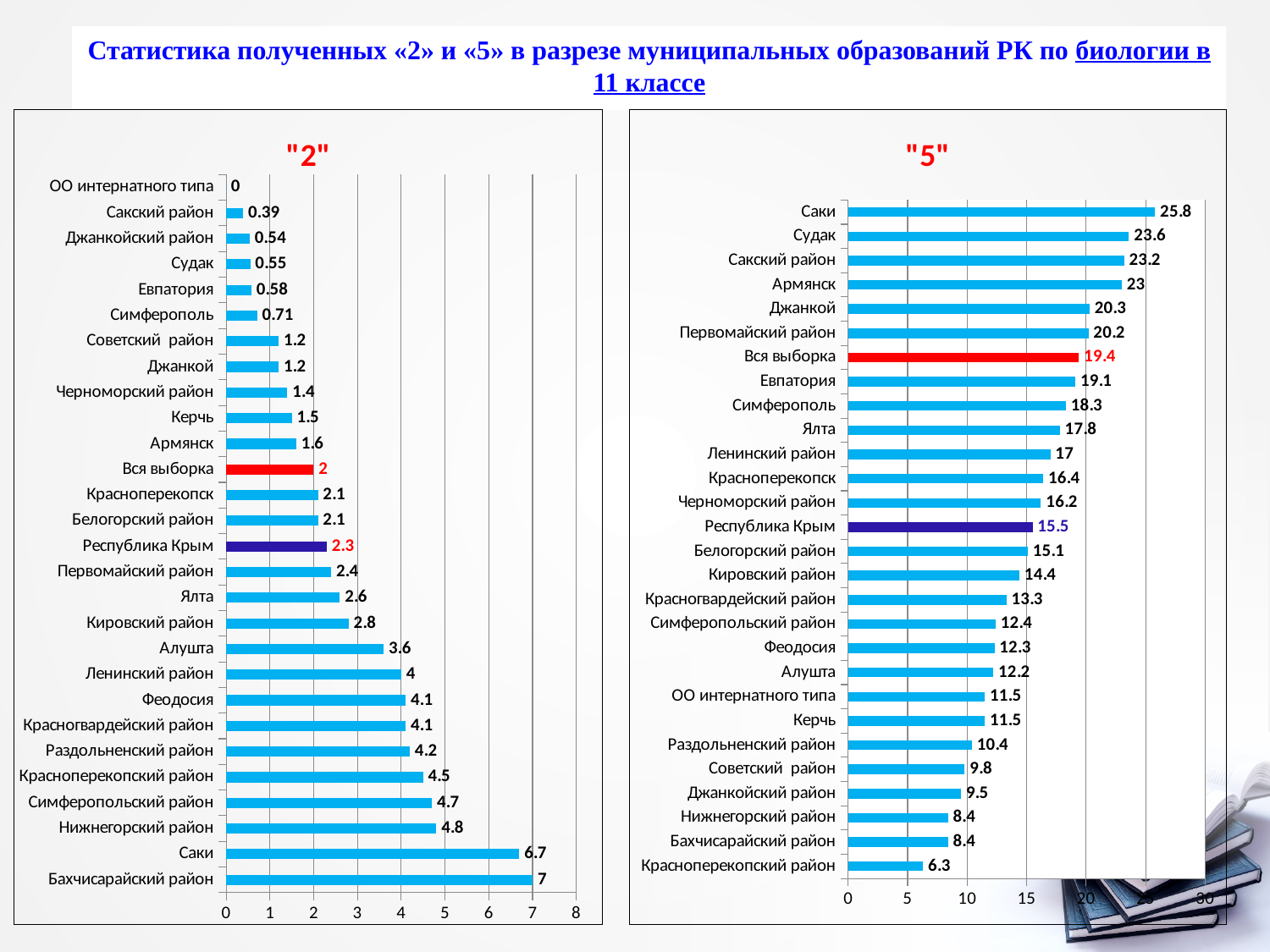
In the "2" chart, which category has the lowest value? ОО интернатного типа In the "5" chart, which category has the highest value? Саки How many categories are shown in the "5" chart? 28 In the "5" chart, what is the difference between Вся выборка and Республика Крым? 3.9 In the "2" chart, what is the value for Республика Крым? 2.3 In the "5" chart, what is the value for Саки? 25.8 In the "2" chart, is the value for Алушта greater or less than 3? greater In the "2" chart, what is the value for Бахчисарайский район? 7 In the "2" chart, what is the difference between Саки and Бахчисарайский район? 0.3 In the "5" chart, which category has the lowest value? Красноперекопский район In the "5" chart, which is larger, Судак or Армянск? Судак What type of chart is the "2" chart? bar chart